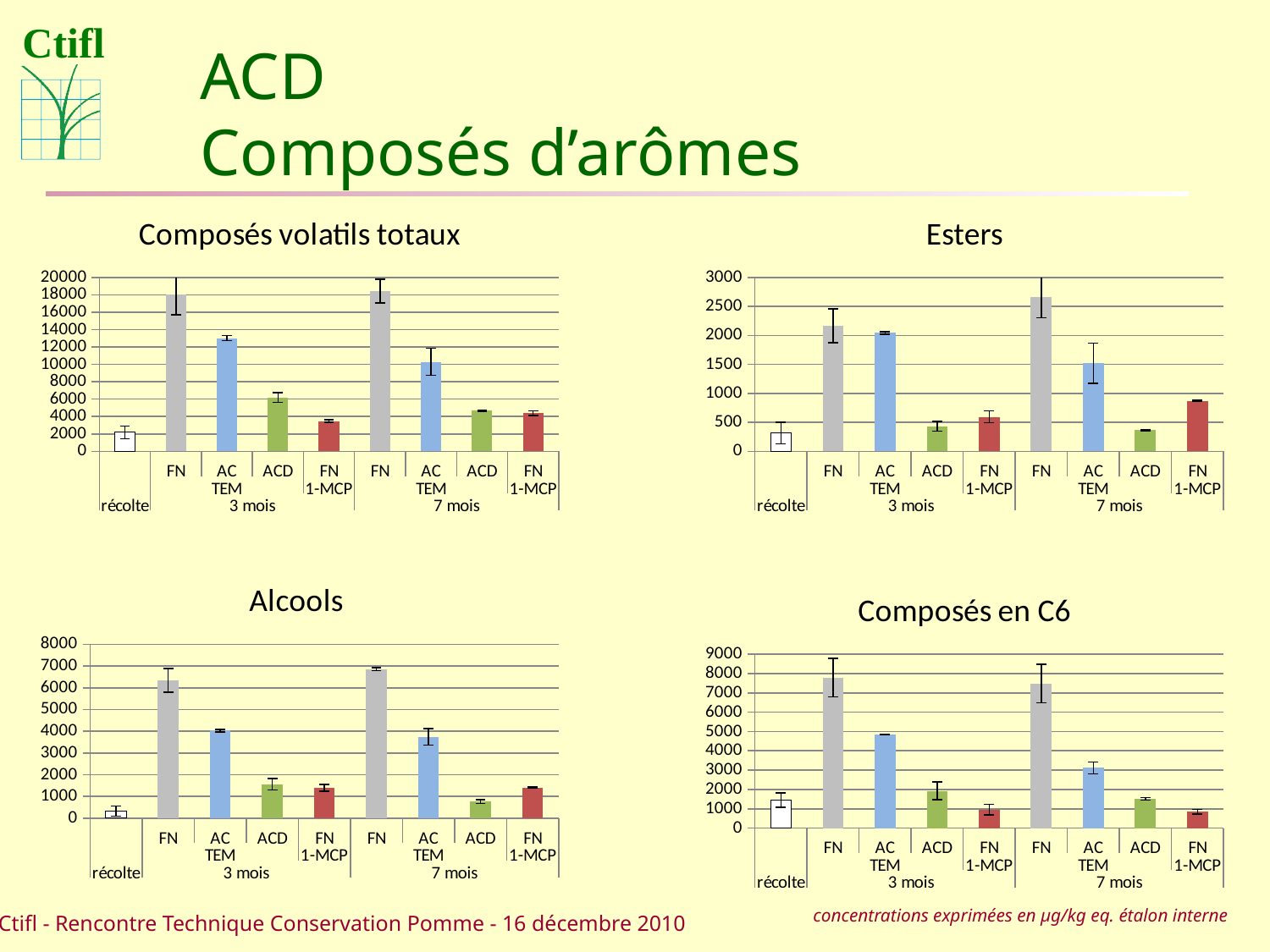
In the 'Composés volatils totaux' chart, is the value for récolte greater or less than 4000? less In the 'Composés en C6' chart, is the value for AC TEM at 3 mois greater or less than 4000? greater In the 'Composés en C6' chart, which is larger at 3 mois: ACD or FN 1-MCP? ACD In the 'Alcools' chart, which is larger at 3 mois: AC TEM or ACD? AC TEM In the 'Esters' chart, is the value for AC TEM at 3 mois greater or less than 1500? greater In the 'Esters' chart, which bar is the highest? FN TEM at 7 mois In the 'Esters' chart, how many bars are plotted? 9 In the 'Alcools' chart, which bar is the lowest? récolte In the 'Alcools' chart, which bar is the highest? FN TEM at 7 mois What kind of chart is the 'Composés volatils totaux' chart? bar chart